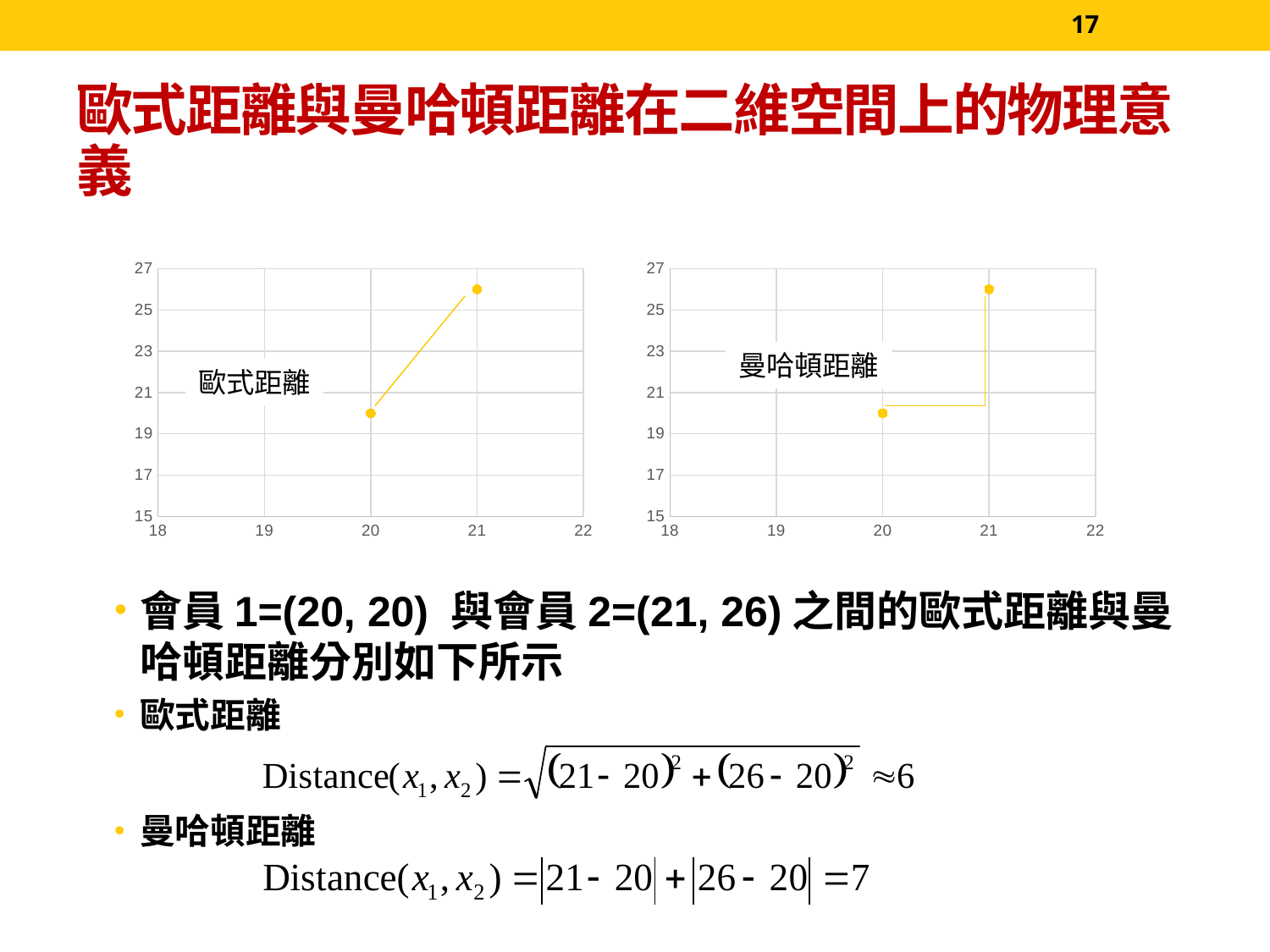
In the left chart (歐式距離), what is the x-value of the upper point? 21 In the right chart (曼哈頓距離), is the y-value of the point at x=20 greater or less than 21? less In the right chart (曼哈頓距離), which point has the lowest y-value? the point at x=20 In the left chart (歐式距離), what is the x-value of the lower point? 20 How many data points are plotted in the left chart (歐式距離)? 2 In the left chart (歐式距離), do the y-values rise or fall as x increases? rise What kind of chart is the left chart labelled 歐式距離? scatter chart What text label appears inside the right chart? 曼哈頓距離 How many data points are plotted in the right chart (曼哈頓距離)? 2 What text label appears inside the left chart? 歐式距離 In the left chart (歐式距離), which point has the higher y-value, the one at x=20 or the one at x=21? the one at x=21 In the right chart (曼哈頓距離), is the y-value of the point at x=21 greater or less than 25? greater